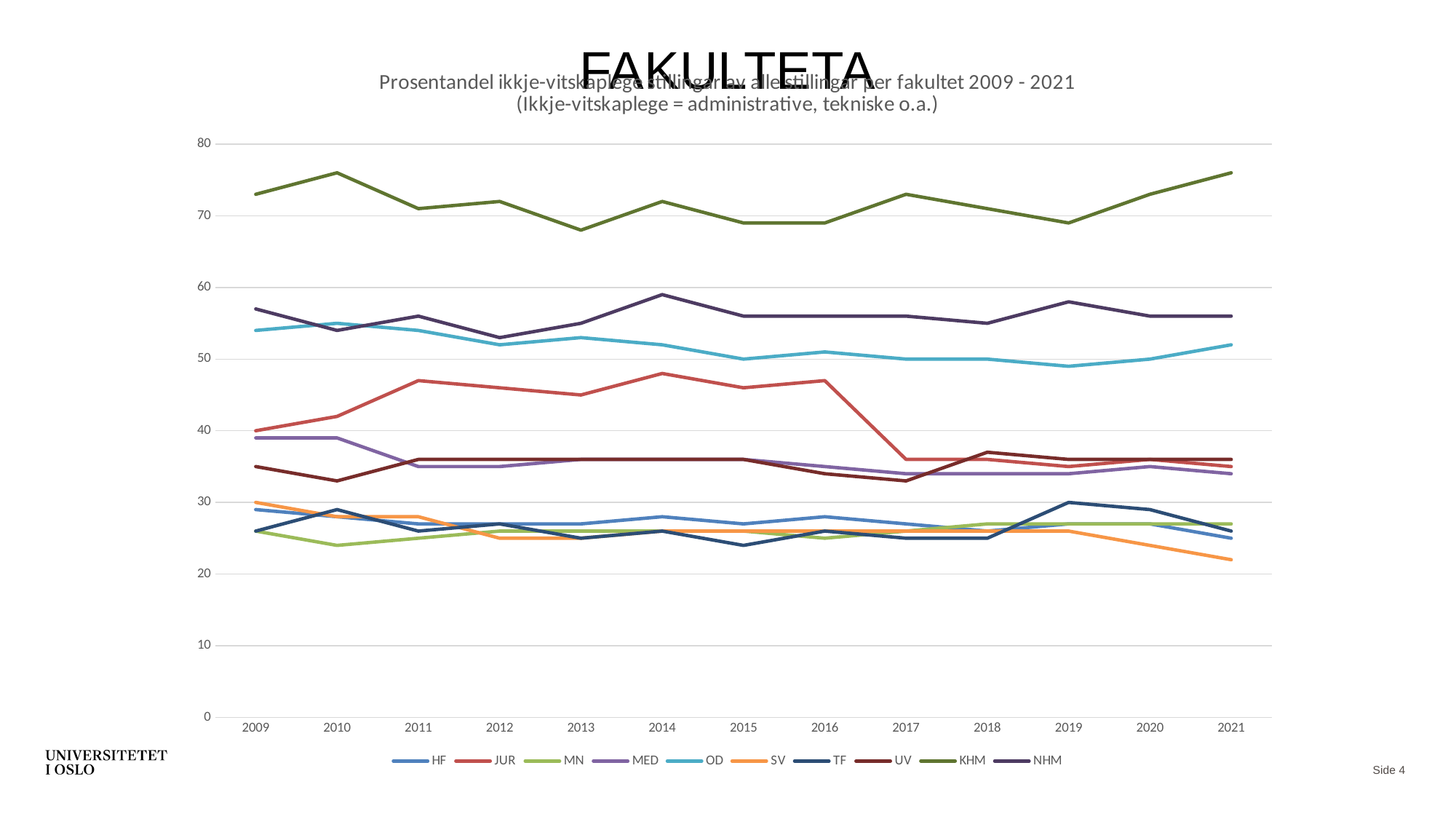
In 2017, which series has the larger value, JUR or OD? OD Is the value for KHM in 2010 greater or less than 70? greater Is the value for JUR in 2017 greater or less than 40? less Does the KHM line rise or fall from 2019 to 2021? rise What kind of chart is shown on the slide? line chart How many years are plotted along the x axis? 13 How many series does the legend list? 10 In 2009, which series has the larger value, JUR or UV? JUR Is the value for NHM in 2009 greater or less than 50? greater Which series has the highest values across the whole period 2009 - 2021? KHM Which series has the lowest value in 2021? SV Does the JUR line rise or fall from 2016 to 2017? fall